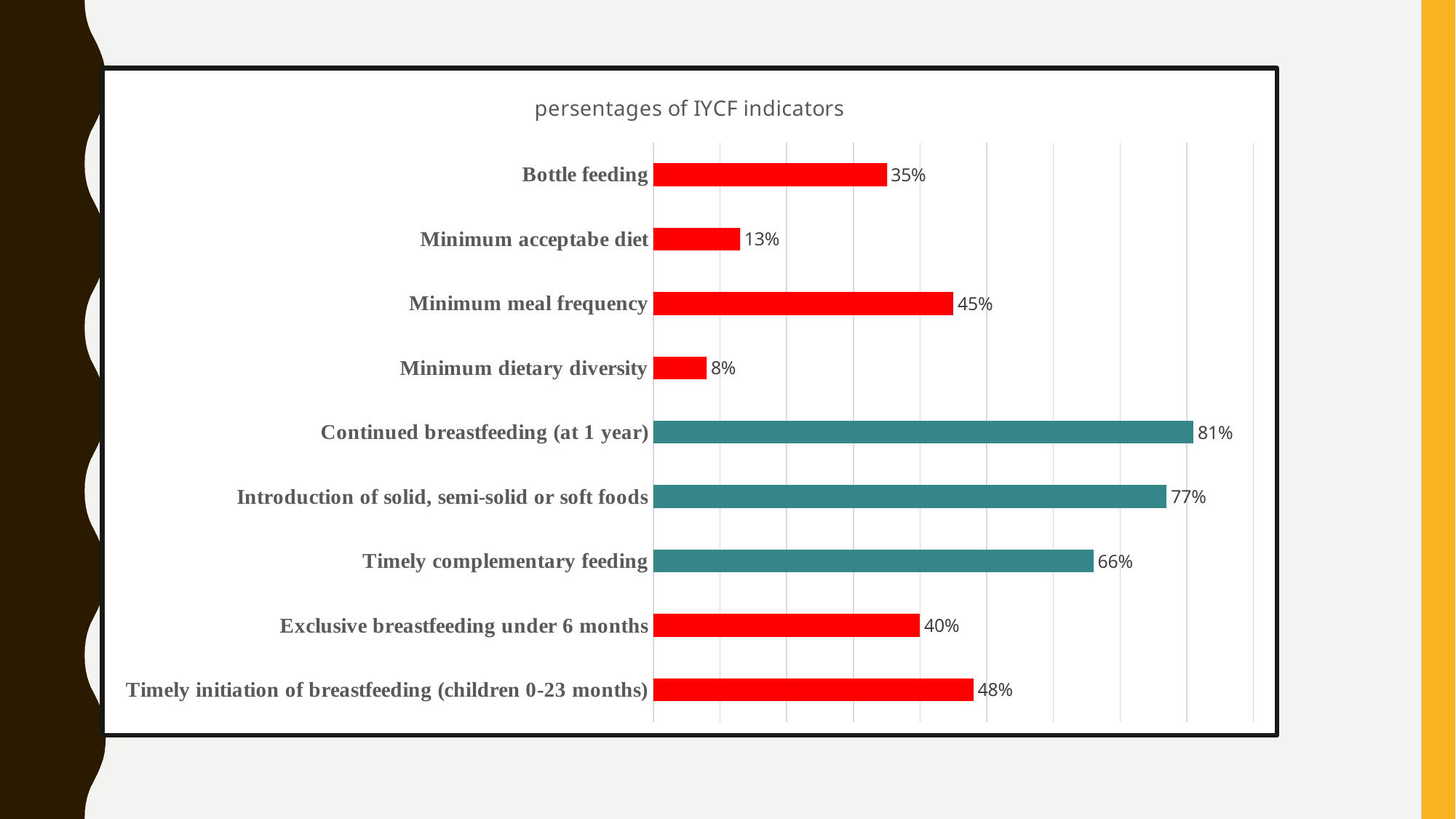
What is the title of the chart? persentages of IYCF indicators Which is larger, Timely initiation of breastfeeding (children 0-23 months) or Exclusive breastfeeding under 6 months? Timely initiation of breastfeeding (children 0-23 months) What kind of chart is shown on the slide? Bar chart What is the value for Exclusive breastfeeding under 6 months? 40% What is the value for Minimum acceptable diet? 13% Which category has the highest value? Continued breastfeeding (at 1 year) How many categories are shown in the chart? 9 What is the value for Bottle feeding? 35% What is the difference between Minimum meal frequency and Minimum dietary diversity? 37% What is the difference between Continued breastfeeding (at 1 year) and Introduction of solid, semi-solid or soft foods? 4% What is the value for Timely complementary feeding? 66% Which category has the lowest value? Minimum dietary diversity